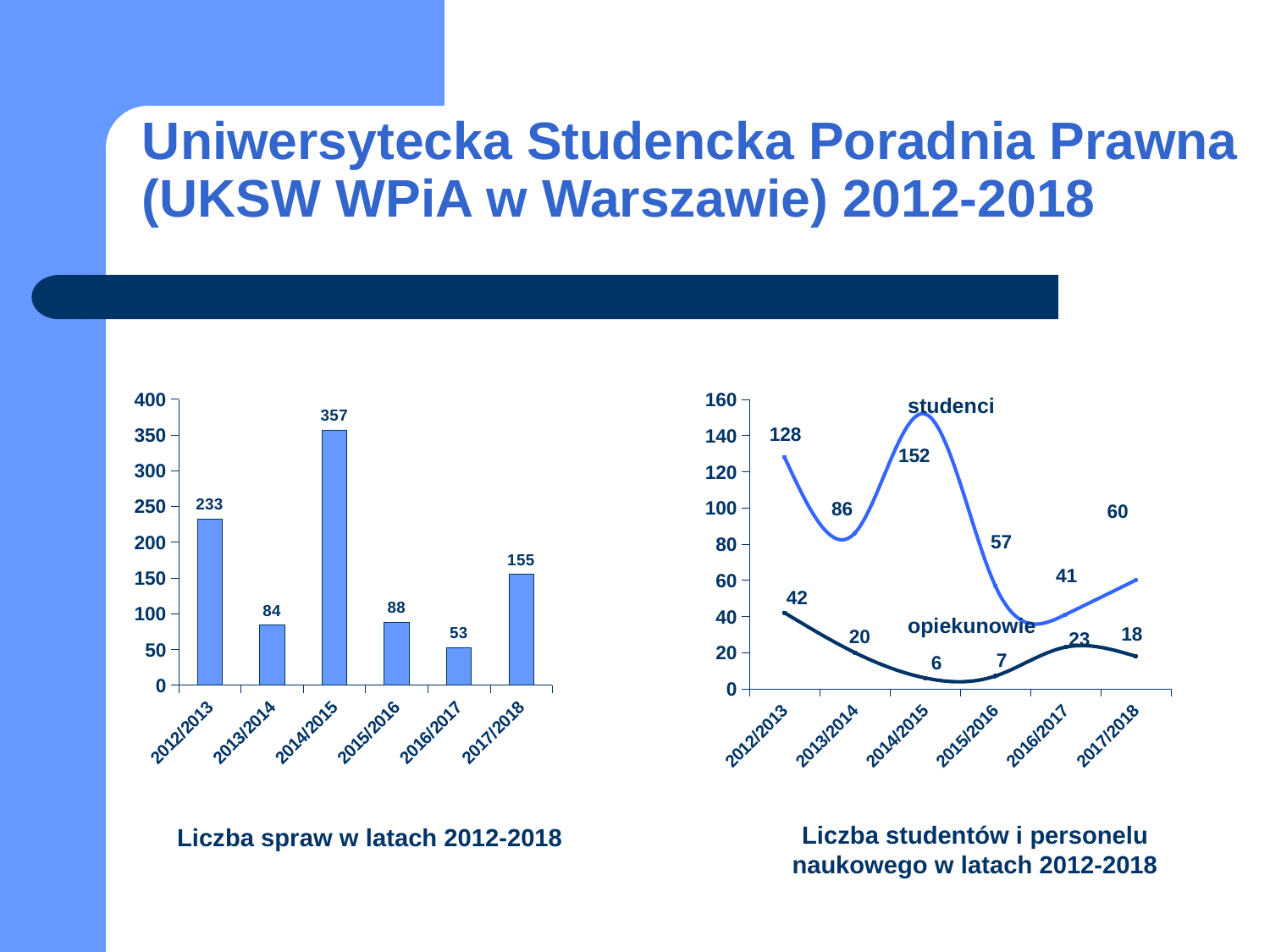
In the left chart (Liczba spraw w latach 2012-2018), what is the difference between the values for 2012/2013 and 2017/2018? 78 In the left chart (Liczba spraw w latach 2012-2018), what is the value for 2014/2015? 357 What kind of chart is the right chart (Liczba studentów i personelu naukowego w latach 2012-2018)? line chart In the left chart (Liczba spraw w latach 2012-2018), which year has the lowest value? 2016/2017 In the right chart (Liczba studentów i personelu naukowego w latach 2012-2018), what is the value for studenci in 2014/2015? 152 In the right chart (Liczba studentów i personelu naukowego w latach 2012-2018), what is the value for opiekunowie in 2012/2013? 42 What kind of chart is the left chart (Liczba spraw w latach 2012-2018)? bar chart In the right chart (Liczba studentów i personelu naukowego w latach 2012-2018), how many data series (lines) are plotted? 2 In the left chart (Liczba spraw w latach 2012-2018), which is larger, the value for 2013/2014 or 2015/2016? 2015/2016 In the right chart (Liczba studentów i personelu naukowego w latach 2012-2018), what is the difference between studenci and opiekunowie in 2017/2018? 42 In the left chart (Liczba spraw w latach 2012-2018), how many years are shown on the x axis? 6 In the right chart (Liczba studentów i personelu naukowego w latach 2012-2018), in which year is the opiekunowie value lowest? 2014/2015